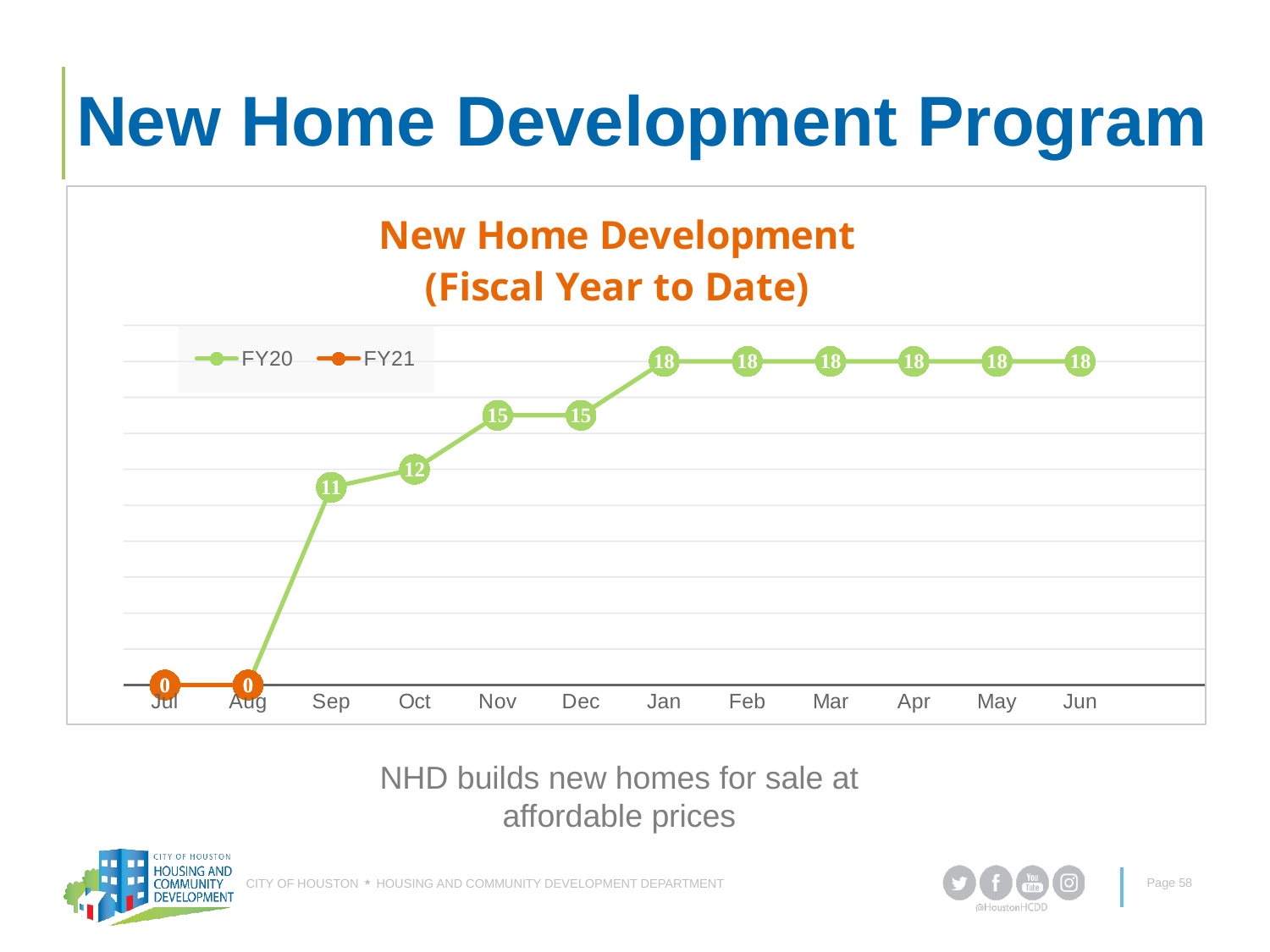
What is the difference between the FY20 values for Jan and Sep? 7 Does the FY20 line rise or fall from Aug to Jan? rise How many series does the legend list? 2 What is the FY20 value for Jun? 18 What is the FY20 value for Sep? 11 What is the FY20 value for Nov? 15 What type of chart is shown on the slide? line chart What is the FY20 value for Oct? 12 What is the title of the chart? New Home Development (Fiscal Year to Date) Which is larger for FY20, the value for Oct or the value for Dec? Dec What is the FY21 value for Aug? 0 How many months are shown on the x axis? 12